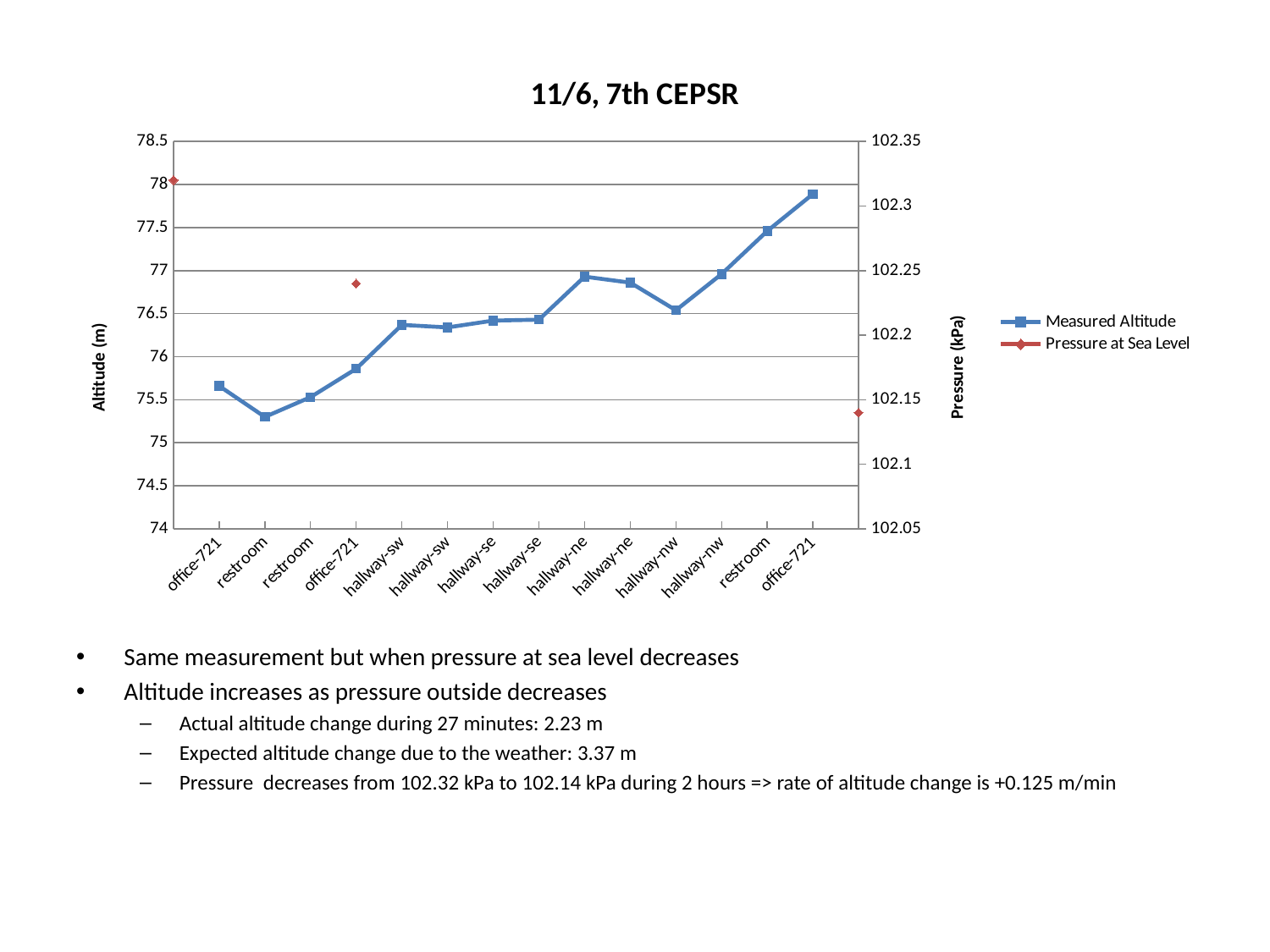
Which point has the lowest Measured Altitude? the first restroom point What is the title of the chart? 11/6, 7th CEPSR How many series does the legend list? 2 Is the Measured Altitude for the last office-721 point greater or less than 77.5? greater What kind of chart is shown on the slide? line chart Does the Pressure at Sea Level series rise or fall across the chart? fall Which point has the highest Measured Altitude? the last office-721 point What is the label of the right-hand vertical axis? Pressure (kPa) Is the Measured Altitude for the first restroom point greater or less than 75.5? less Is the Measured Altitude for the first office-721 point greater or less than 75.5? greater How many categories are shown along the x axis? 14